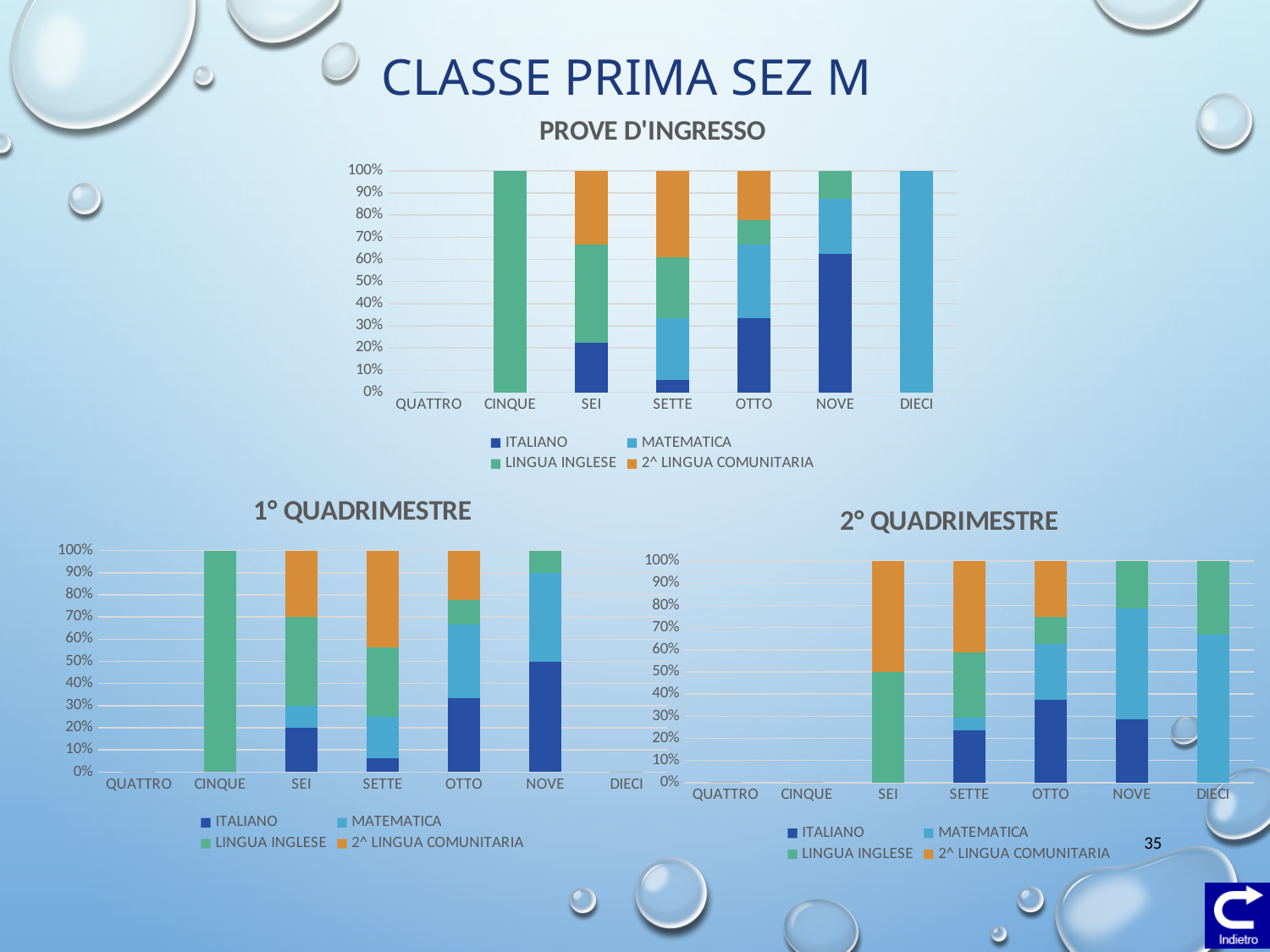
In the 1° QUADRIMESTRE chart, how many categories have a bar plotted? 5 In the PROVE D'INGRESSO chart, which has the larger ITALIANO value, NOVE or OTTO? NOVE In the PROVE D'INGRESSO chart, is the ITALIANO value for NOVE greater or less than 50%? greater How many series does the legend of the PROVE D'INGRESSO chart list? 4 In the 2° QUADRIMESTRE chart, which has the larger ITALIANO value, OTTO or SEI? OTTO In the 1° QUADRIMESTRE chart, is the ITALIANO value for SETTE greater or less than 10%? less What kind of chart is the PROVE D'INGRESSO chart? bar chart What is the title of the chart at the top of the slide? PROVE D'INGRESSO In the 1° QUADRIMESTRE chart, is the ITALIANO value for NOVE greater or less than 40%? greater How many categories are shown on the x axis of the 1° QUADRIMESTRE chart? 7